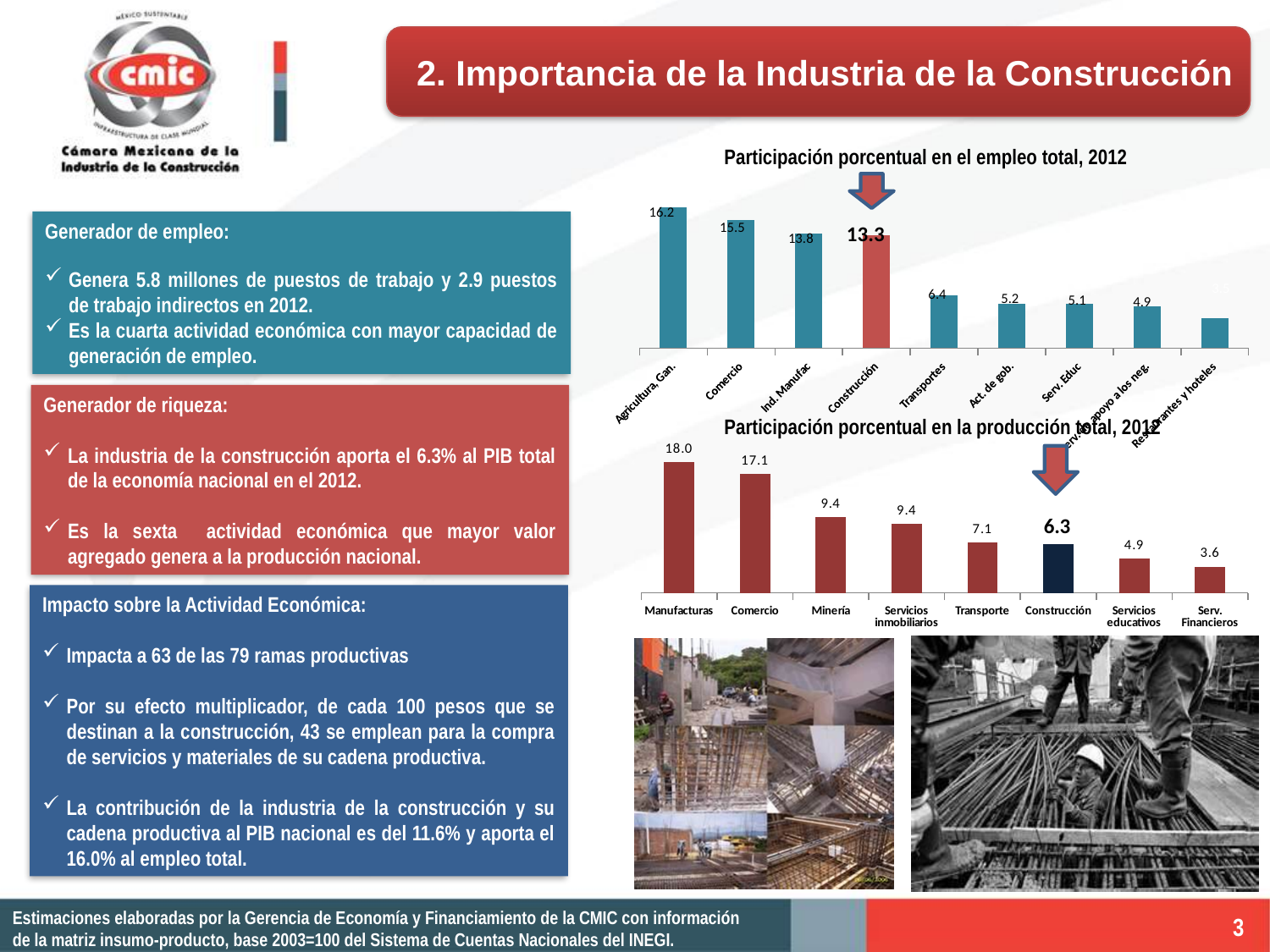
In the chart 'Participación porcentual en la producción total, 2012', how many categories are shown? 8 In the chart 'Participación porcentual en el empleo total, 2012', what is the value for Comercio? 15.5 What type of chart is 'Participación porcentual en la producción total, 2012'? Bar chart In the chart 'Participación porcentual en la producción total, 2012', what is the value for Construcción? 6.3 In the chart 'Participación porcentual en el empleo total, 2012', which is larger, Transportes or Act. de gob.? Transportes In the chart 'Participación porcentual en el empleo total, 2012', what is the value for Construcción? 13.3 In the chart 'Participación porcentual en el empleo total, 2012', what is the difference between Agricultura, Gan. and Construcción? 2.9 In the chart 'Participación porcentual en la producción total, 2012', what is the difference between Manufacturas and Comercio? 0.9 In the chart 'Participación porcentual en la producción total, 2012', which category has the lowest value? Serv. Financieros In the chart 'Participación porcentual en la producción total, 2012', what is the value for Manufacturas? 18.0 In the chart 'Participación porcentual en el empleo total, 2012', how many bars are plotted? 9 In the chart 'Participación porcentual en el empleo total, 2012', which category has the highest value? Agricultura, Gan.